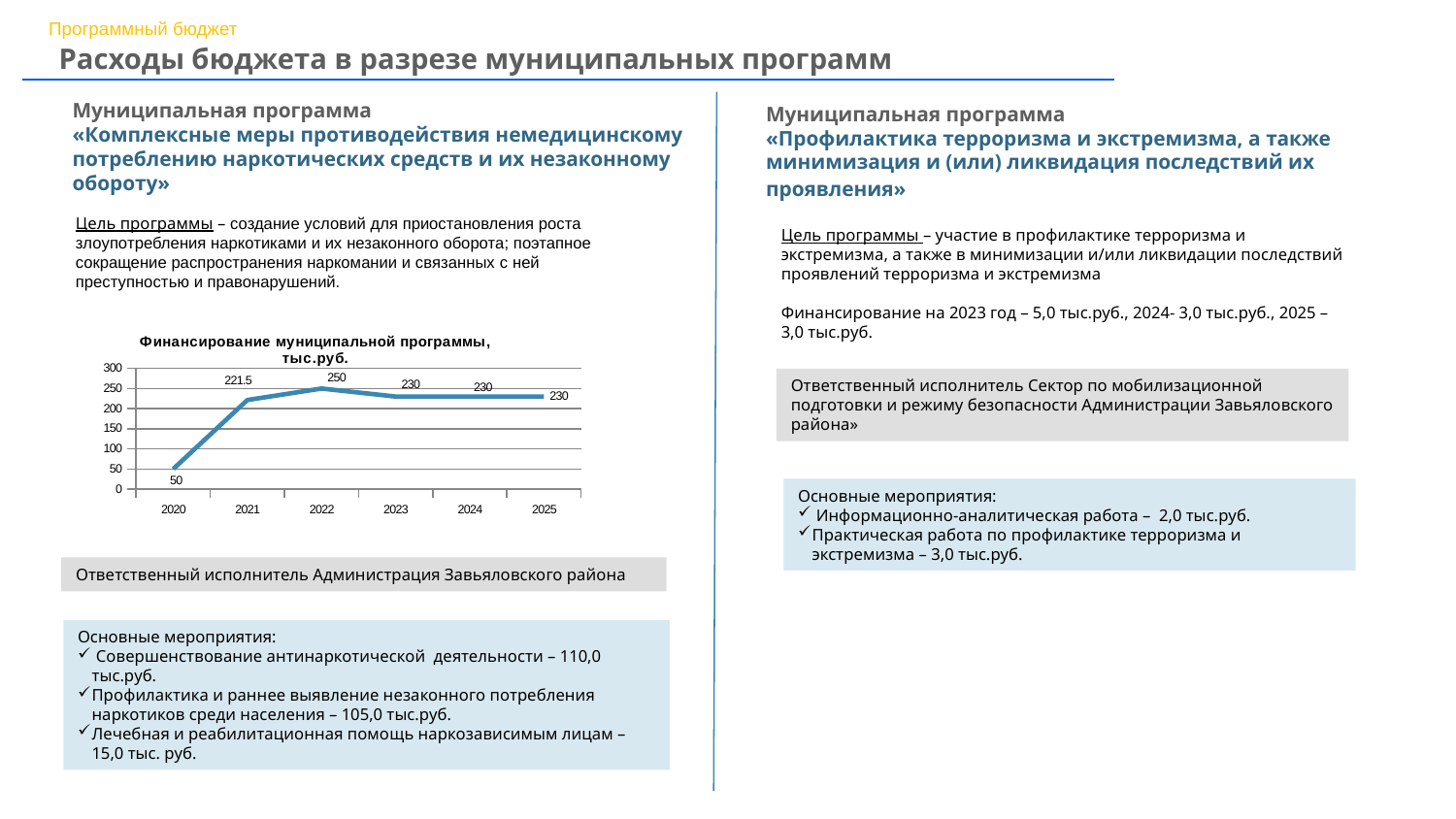
What is the difference between the values for 2021 and 2020 in the chart 'Финансирование муниципальной программы, тыс.руб.'? 171.5 What is the value for 2020 in the chart 'Финансирование муниципальной программы, тыс.руб.'? 50 In the chart 'Финансирование муниципальной программы, тыс.руб.', which is larger: the value for 2021 or the value for 2022? 2022 What type of chart is used to show 'Финансирование муниципальной программы, тыс.руб.'? line chart Which year has the highest value in the chart 'Финансирование муниципальной программы, тыс.руб.'? 2022 What is the value for 2021 in the chart 'Финансирование муниципальной программы, тыс.руб.'? 221.5 How many years are plotted in the chart 'Финансирование муниципальной программы, тыс.руб.'? 6 What is the value for 2025 in the chart 'Финансирование муниципальной программы, тыс.руб.'? 230 What is the difference between the values for 2022 and 2023 in the chart 'Финансирование муниципальной программы, тыс.руб.'? 20 In the chart 'Финансирование муниципальной программы, тыс.руб.', does the value rise or fall from 2020 to 2022? rise Which year has the lowest value in the chart 'Финансирование муниципальной программы, тыс.руб.'? 2020 What is the value for 2022 in the chart 'Финансирование муниципальной программы, тыс.руб.'? 250